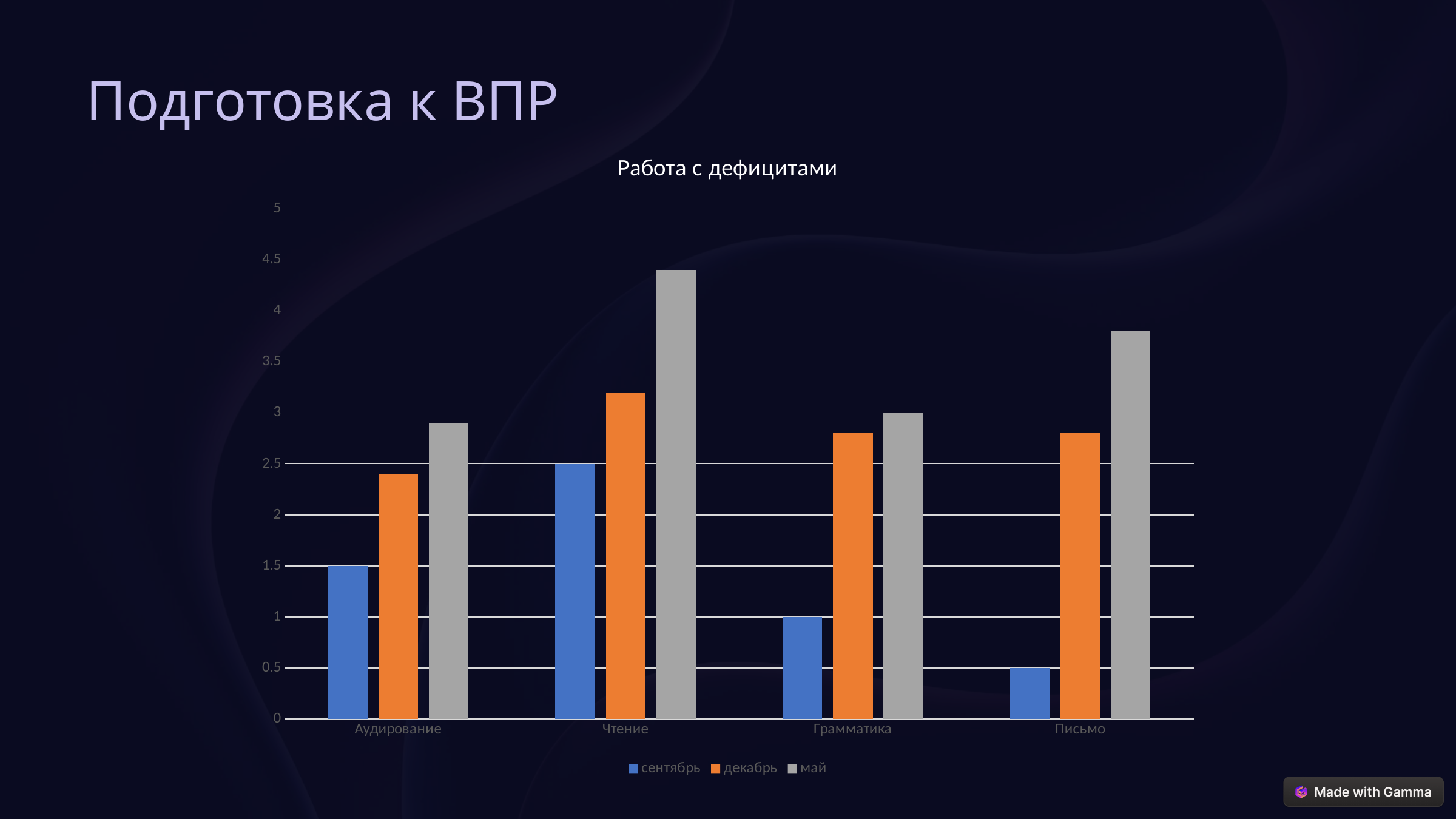
Is the value for декабрь in the Аудирование category greater or less than 2.5? less What is the value for сентябрь in the Письмо category? 0.5 What is the title of the chart? Работа с дефицитами What kind of chart is shown on the slide? bar chart What is the value for сентябрь in the Чтение category? 2.5 What is the value for май in the Грамматика category? 3 Is the value for май in the Чтение category greater or less than 4? greater What is the value for сентябрь in the Аудирование category? 1.5 Which category has the highest value for the май series? Чтение How many categories are shown on the x axis? 4 How many series does the legend list? 3 Which category has the lowest value for the сентябрь series? Письмо